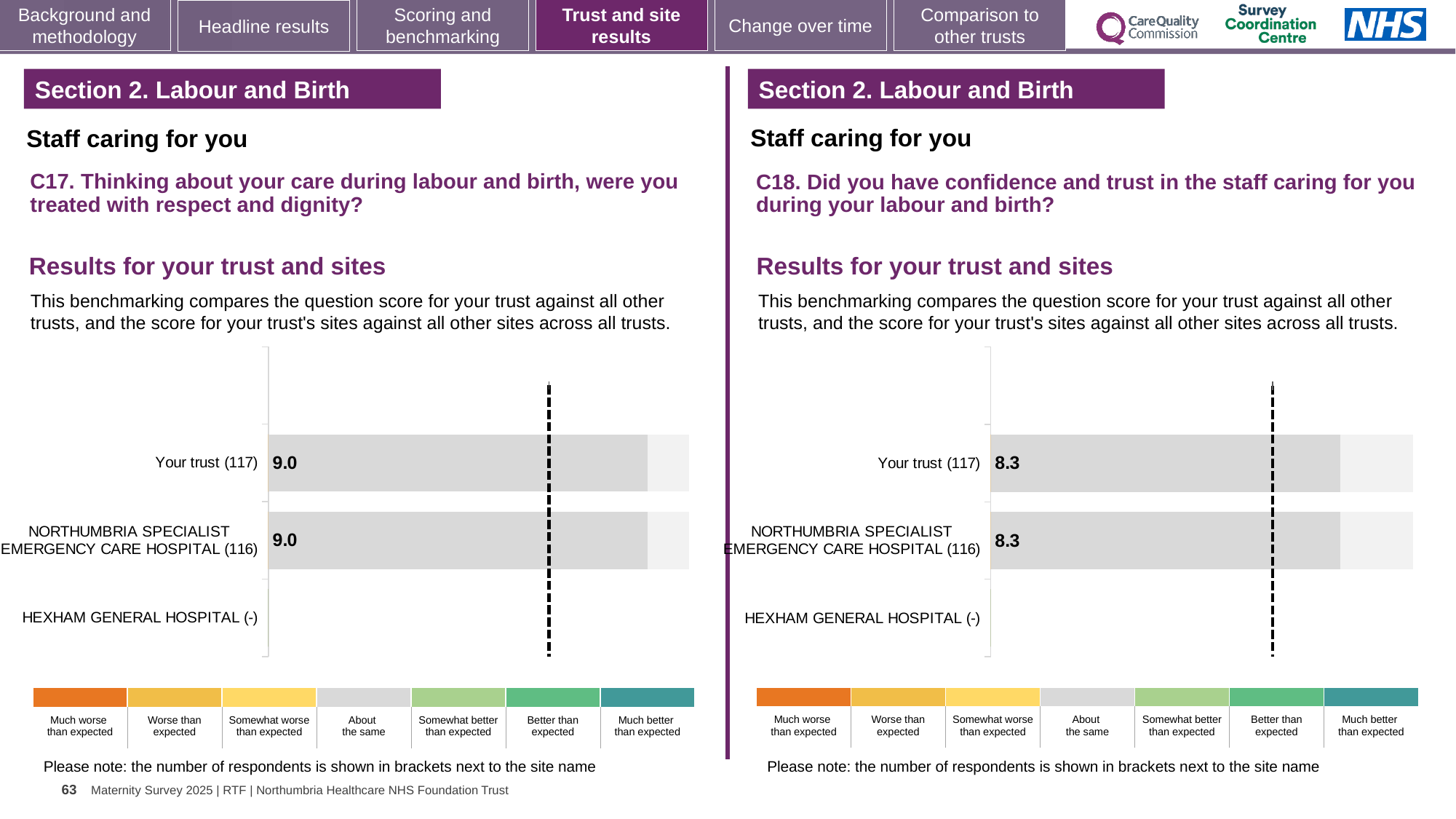
On the C18 chart (right), what is the score for Your trust (117)? 8.3 What kind of chart is used on the C18 chart (right)? Bar chart How many respondents are shown in brackets for Northumbria Specialist Emergency Care Hospital on the C18 chart (right)? 116 Which is larger: the Your trust score on the C17 chart (left) or the Your trust score on the C18 chart (right)? C17 (left) On the C18 chart (right), what is the score for Northumbria Specialist Emergency Care Hospital (116)? 8.3 How many categories (rows) are listed on the C17 chart (left)? 3 What is the difference between the Your trust score on the C17 chart (left) and the Your trust score on the C18 chart (right)? 0.7 On the C17 chart (left), which category has no bar plotted? Hexham General Hospital (-) On the C17 chart (left), what is the score for Your trust (117)? 9.0 On the C17 chart (left), what is the score for Northumbria Specialist Emergency Care Hospital (116)? 9.0 How many benchmark bands does the colour key below the C17 chart (left) show? 7